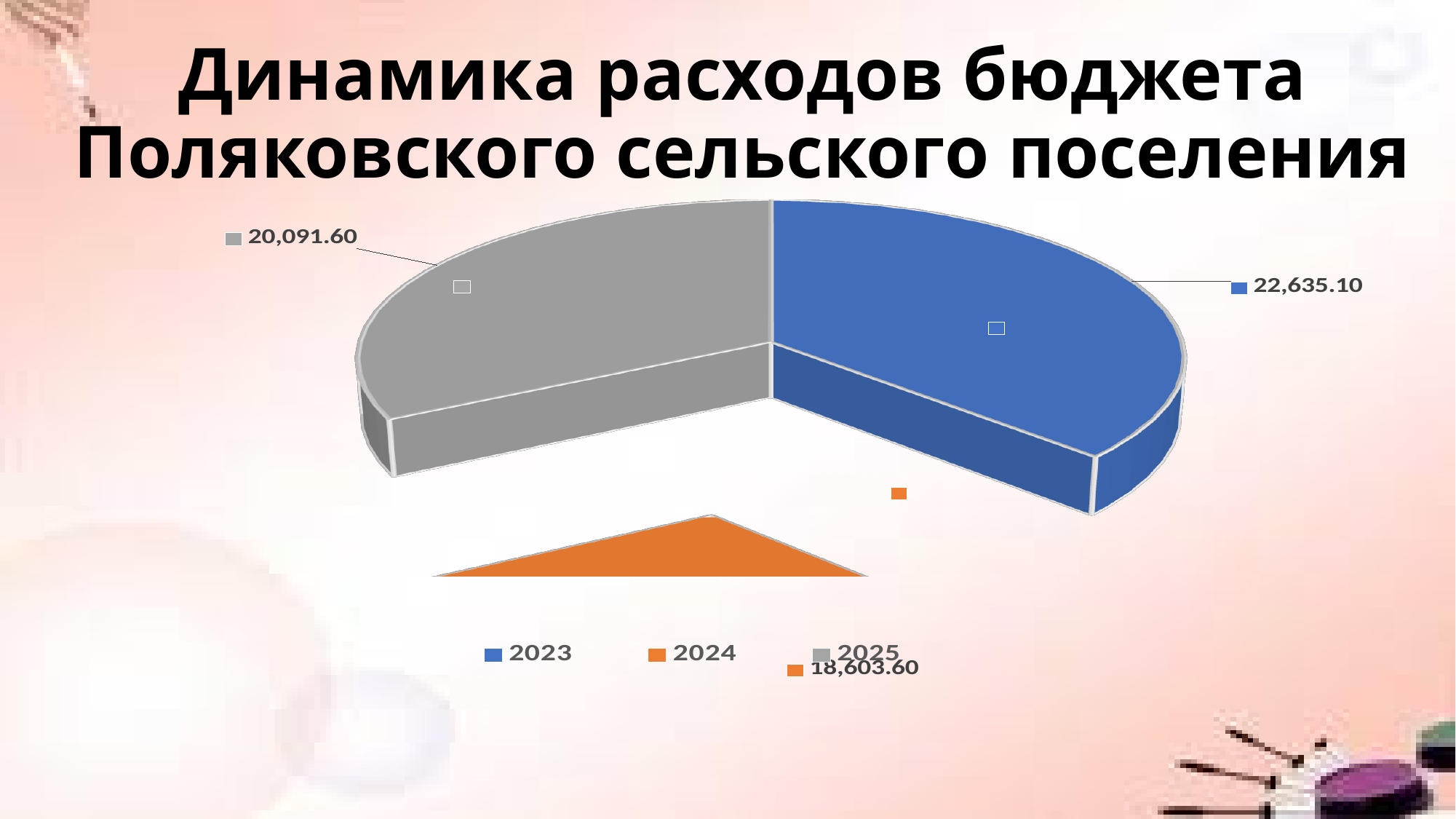
What is the difference between the values for 2025 and 2024? 1,488.00 How many entries does the legend list? 3 Which year has the lowest value? 2024 Which year has the highest value? 2023 Which is larger, the value for 2024 or the value for 2025? 2025 What is the difference between the values for 2023 and 2025? 2,543.50 How many slices does the pie chart have? 3 What is the value for 2024? 18,603.60 What colour is the slice for 2024? orange What is the value for 2025? 20,091.60 What type of chart is shown on the slide? pie chart What is the value for 2023? 22,635.10